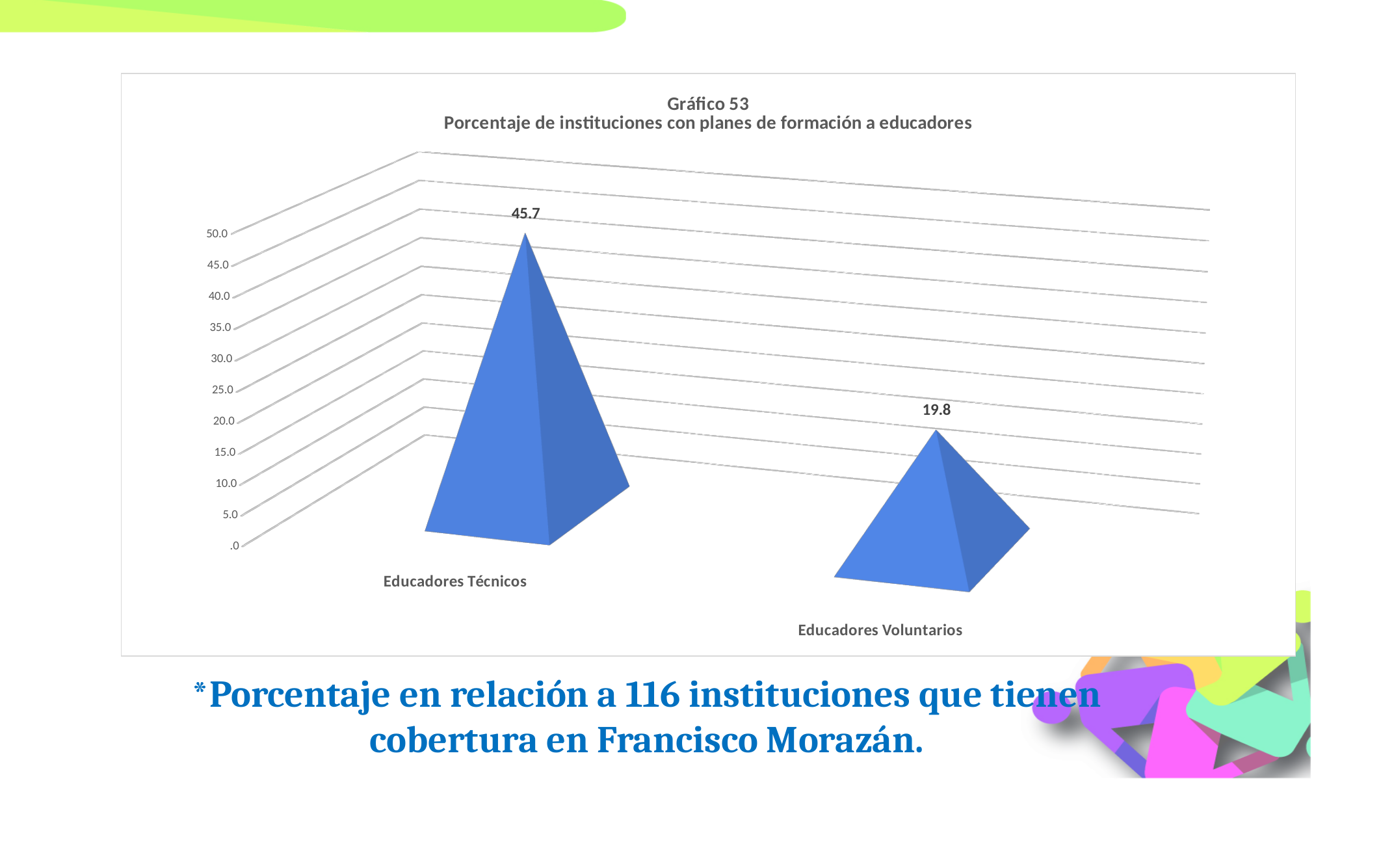
What kind of chart is shown on the slide? Bar chart Is the value for Educadores Voluntarios greater or less than 25.0? less What is the highest value shown on the vertical axis? 50.0 What is the value for Educadores Técnicos? 45.7 What is the difference between the values for Educadores Técnicos and Educadores Voluntarios? 25.9 Which category has the highest value? Educadores Técnicos Which is larger, the value for Educadores Técnicos or the value for Educadores Voluntarios? Educadores Técnicos What is the value for Educadores Voluntarios? 19.8 What is the title of the chart? Gráfico 53 Porcentaje de instituciones con planes de formación a educadores How many categories are shown in the chart? 2 Which category has the lowest value? Educadores Voluntarios Is the value for Educadores Técnicos greater or less than 40.0? greater